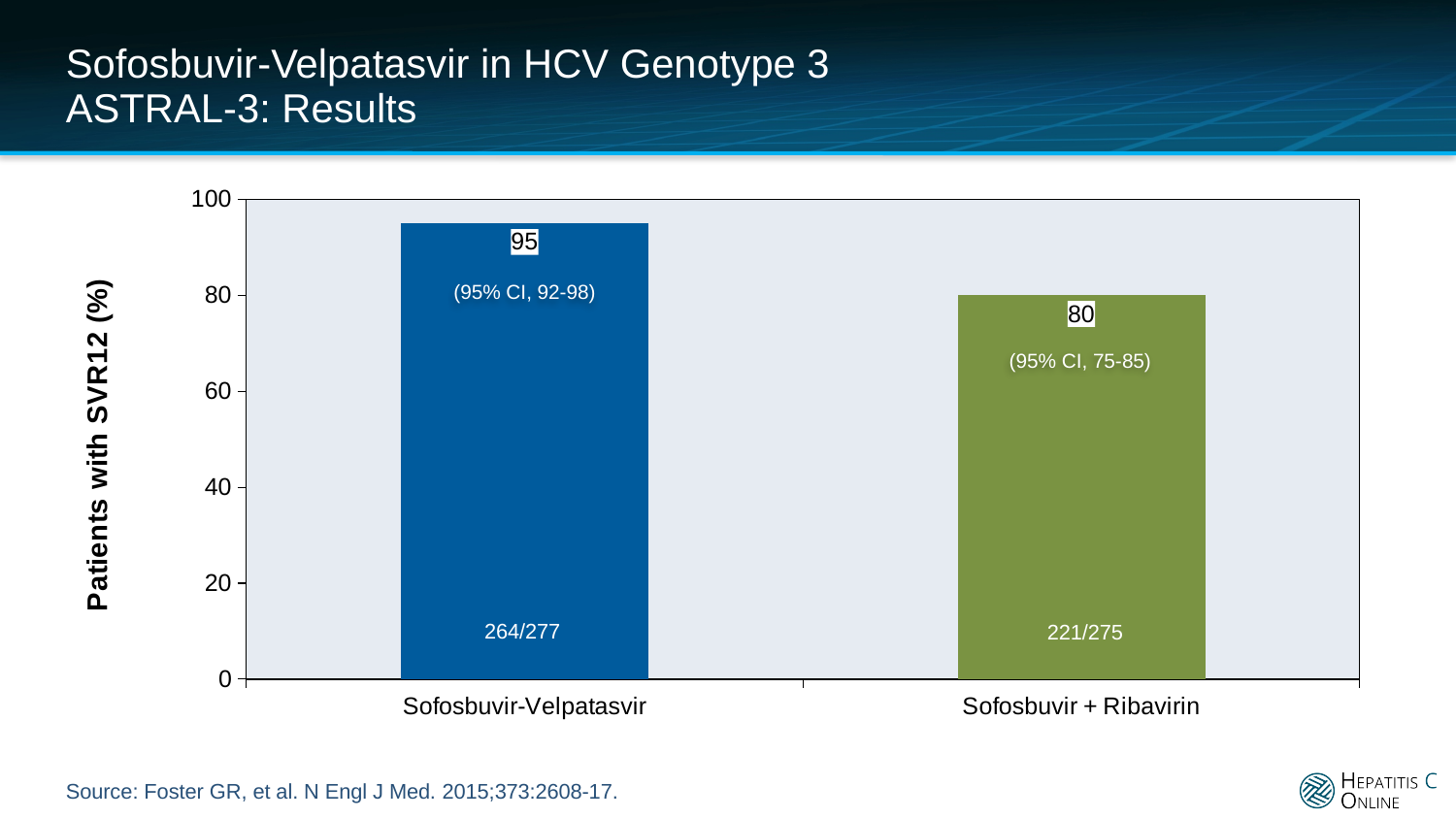
How many treatment arms are shown in the chart? 2 Which treatment arm has the highest SVR12 rate? Sofosbuvir-Velpatasvir What is the difference in SVR12 rate between Sofosbuvir-Velpatasvir and Sofosbuvir + Ribavirin? 15 What is the 95% confidence interval shown for Sofosbuvir-Velpatasvir? 92-98 Which treatment arm has the lowest SVR12 rate? Sofosbuvir + Ribavirin What is the SVR12 rate for Sofosbuvir + Ribavirin? 80 What is the SVR12 rate for Sofosbuvir-Velpatasvir? 95 What kind of chart is shown on the slide? Bar chart Is the SVR12 rate for Sofosbuvir + Ribavirin greater or less than 60? greater What is the label of the y-axis? Patients with SVR12 (%) What patient fraction is shown on the Sofosbuvir + Ribavirin bar? 221/275 Which has a higher SVR12 rate, Sofosbuvir-Velpatasvir or Sofosbuvir + Ribavirin? Sofosbuvir-Velpatasvir